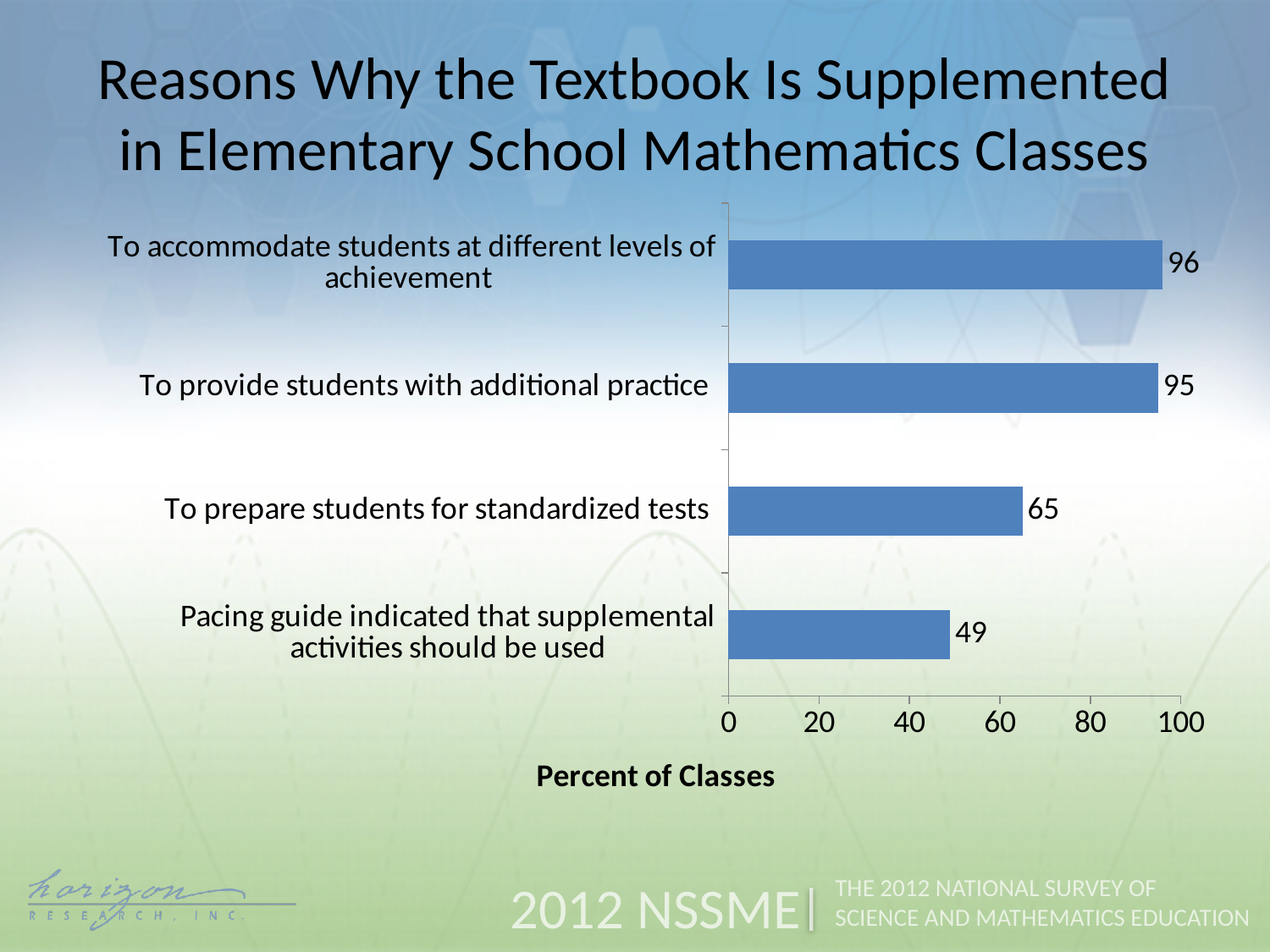
What is the difference between the values for 'To accommodate students at different levels of achievement' and 'To prepare students for standardized tests'? 31 What is the difference between the values for 'To prepare students for standardized tests' and 'Pacing guide indicated that supplemental activities should be used'? 16 What kind of chart is shown on the slide? Bar chart Which reason has the lowest percent of classes? Pacing guide indicated that supplemental activities should be used How many reasons are shown in the chart? 4 What percent of classes supplement the textbook to prepare students for standardized tests? 65 What is the label of the horizontal axis? Percent of Classes What is the value for 'Pacing guide indicated that supplemental activities should be used'? 49 What is the value for 'To provide students with additional practice'? 95 Which reason has the highest percent of classes? To accommodate students at different levels of achievement What percent of classes supplement the textbook to accommodate students at different levels of achievement? 96 Which is larger: the value for 'To provide students with additional practice' or 'To prepare students for standardized tests'? To provide students with additional practice